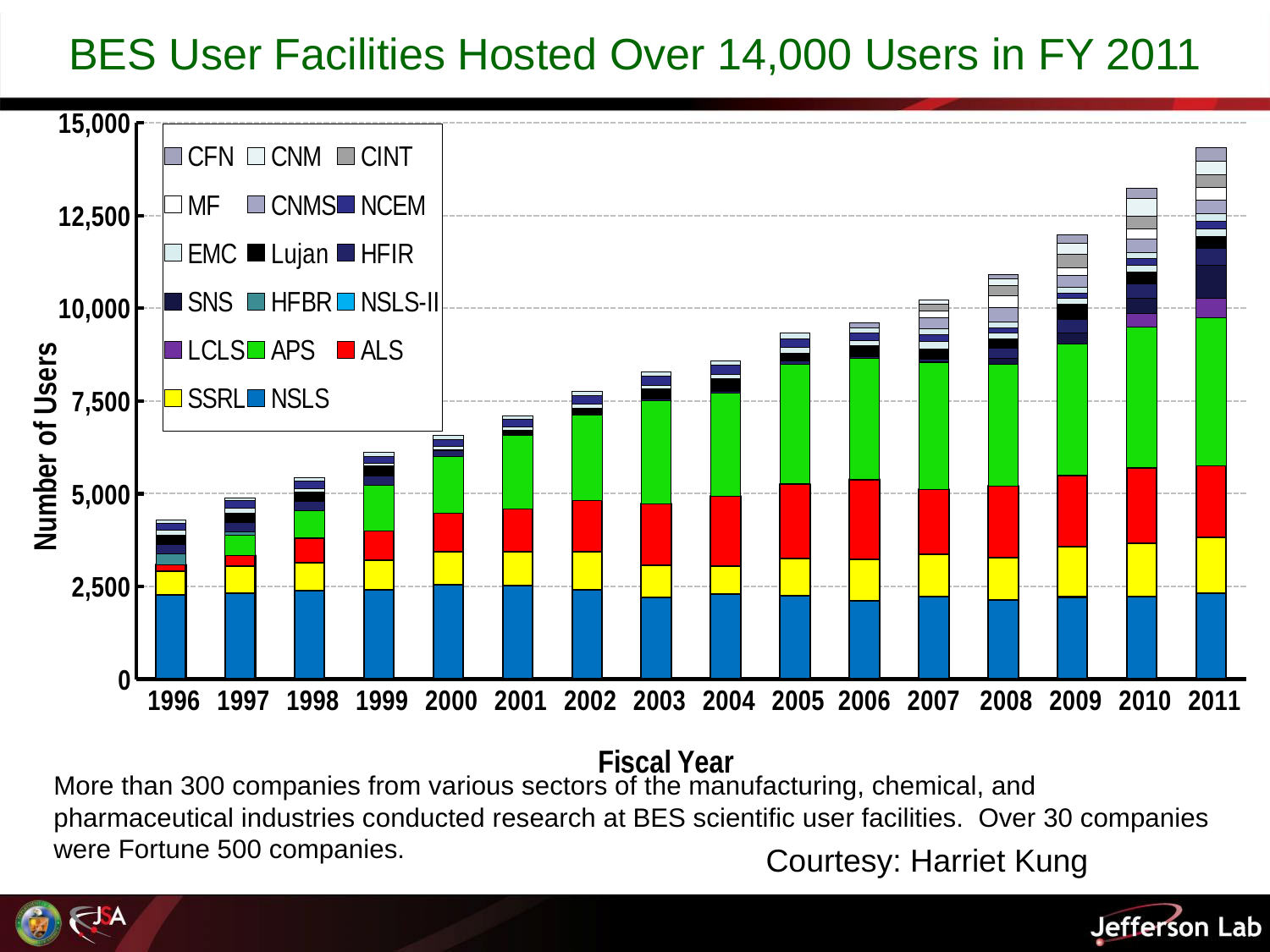
Does the total number of users generally rise or fall from 1996 to 2011? rise Which fiscal year has the highest total number of users? 2011 Is the total number of users in 1996 greater or less than 5,000? less What is the label on the vertical axis of the chart? Number of Users Which fiscal year has a larger total number of users, 2005 or 2010? 2010 Is the total number of users in 2011 greater or less than 12,500? greater How many fiscal years are shown along the x axis of the chart? 16 Which fiscal year has the lowest total number of users? 1996 What kind of chart is shown on the slide? stacked bar chart How many series (facilities) does the chart's legend list? 17 Is the total number of users in 2005 greater or less than 10,000? less